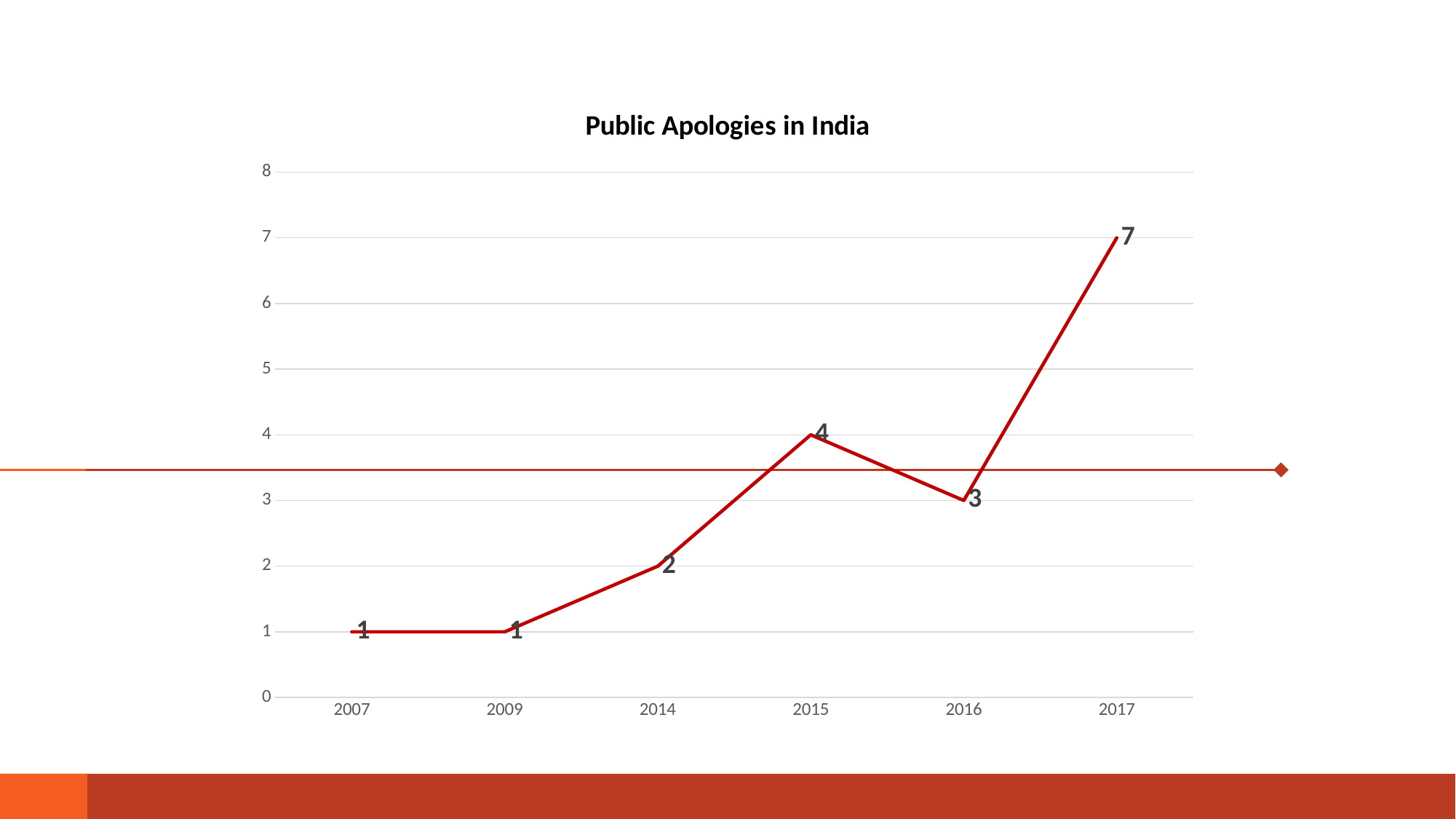
Which year has the highest value? 2017 What is the value for 2014? 2 Which is larger, the value for 2015 or the value for 2016? 2015 What is the value for 2016? 3 What is the difference between the values for 2017 and 2016? 4 Does the value rise or fall from 2015 to 2016? fall How many years are plotted on the x axis? 6 What is the value for 2017? 7 What is the difference between the values for 2015 and 2014? 2 What is the title of the chart? Public Apologies in India What is the value for 2015? 4 What kind of chart is shown on the slide? line chart